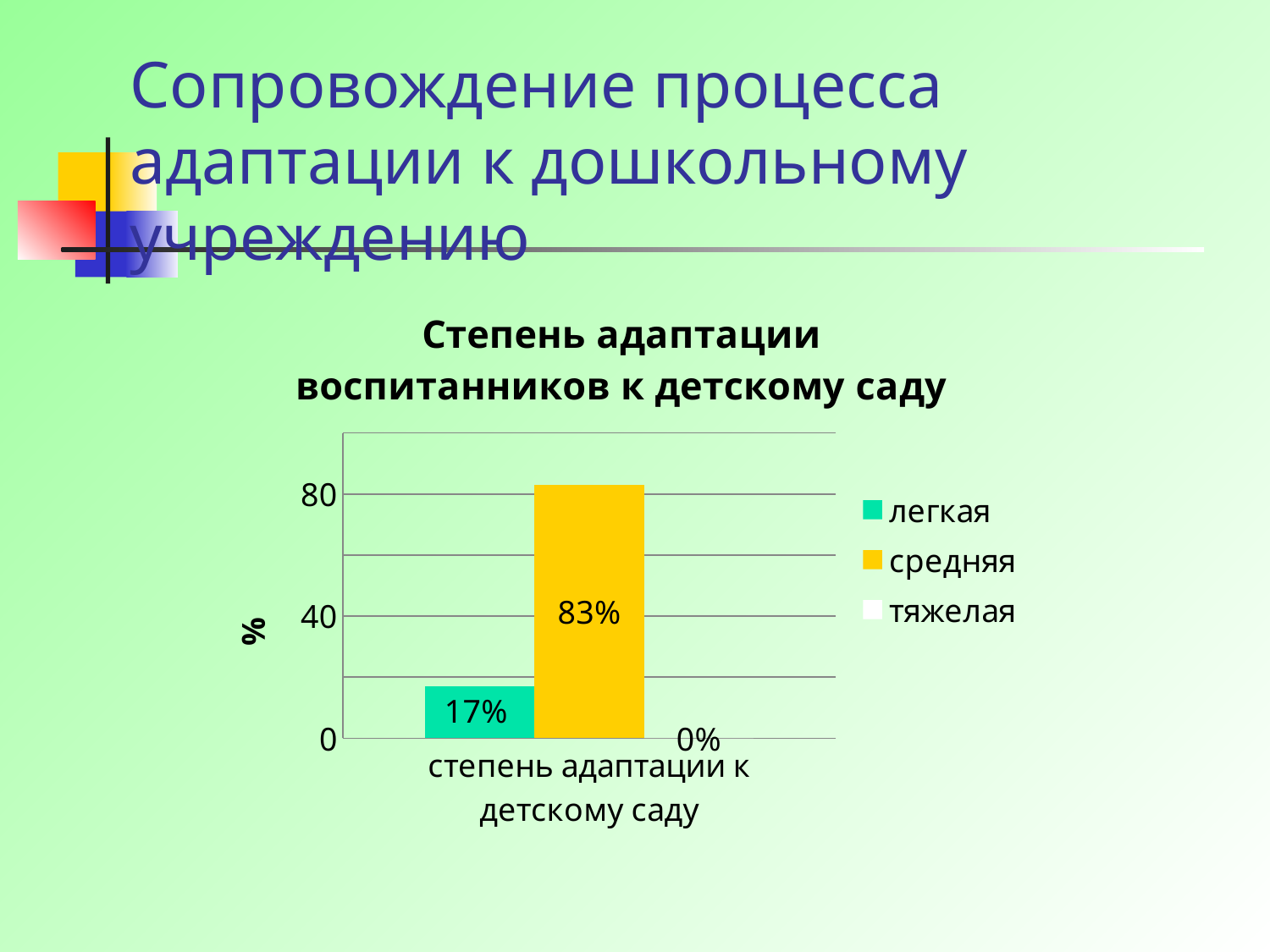
What is the value for the 'легкая' series? 17% What kind of chart is shown on the slide? bar chart Which series has the lowest value? тяжелая What is the title of the chart? Степень адаптации воспитанников к детскому саду Which is larger, the value for 'легкая' or the value for 'средняя'? средняя Which series has the highest value? средняя What is the value for the 'средняя' series? 83% What is the value for the 'тяжелая' series? 0% What colour is the bar for the 'средняя' series? yellow What is the difference between the 'средняя' and 'легкая' values? 66% How many series does the legend list? 3 Is the value for 'средняя' greater or less than 80? greater